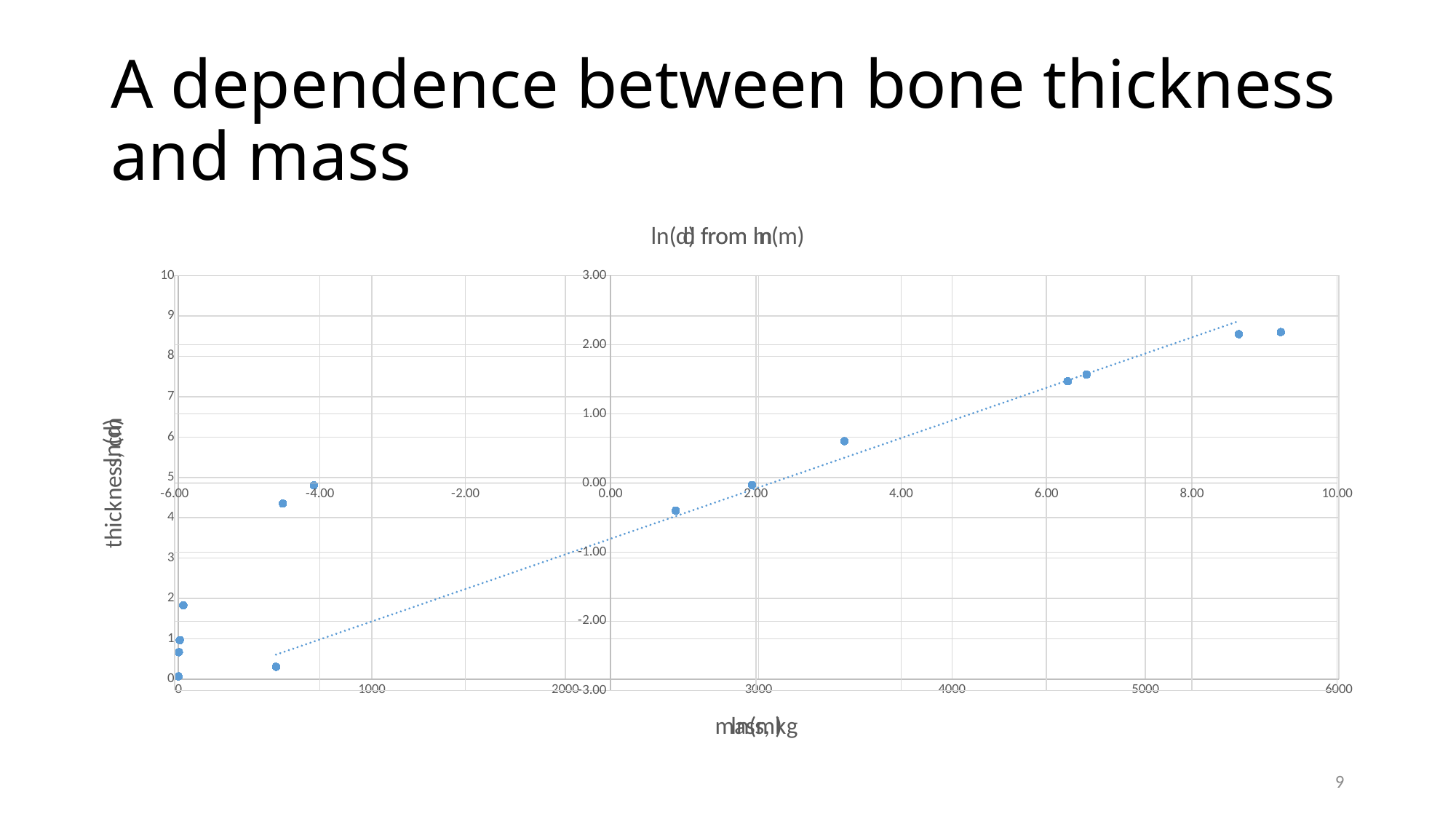
On the chart whose x axis runs from -6.00 to 10.00, is the y value of the point at about x = 6.3 greater or less than 1.00? greater What is the highest tick value shown on the x axis that runs from -6.00? 10.00 What is the highest tick value shown on the y axis that runs from -3.00? 3.00 Do the plotted points rise or fall as the x-axis value increases? rise On the chart whose x axis runs from -6.00 to 10.00, is the y value of the point at about x = 3.2 greater or less than 0.00? greater What kind of chart is shown on the slide? scatter chart On the chart whose x axis runs from -6.00 to 10.00, is the y value of the point at about x = 0.9 greater or less than 0.00? less